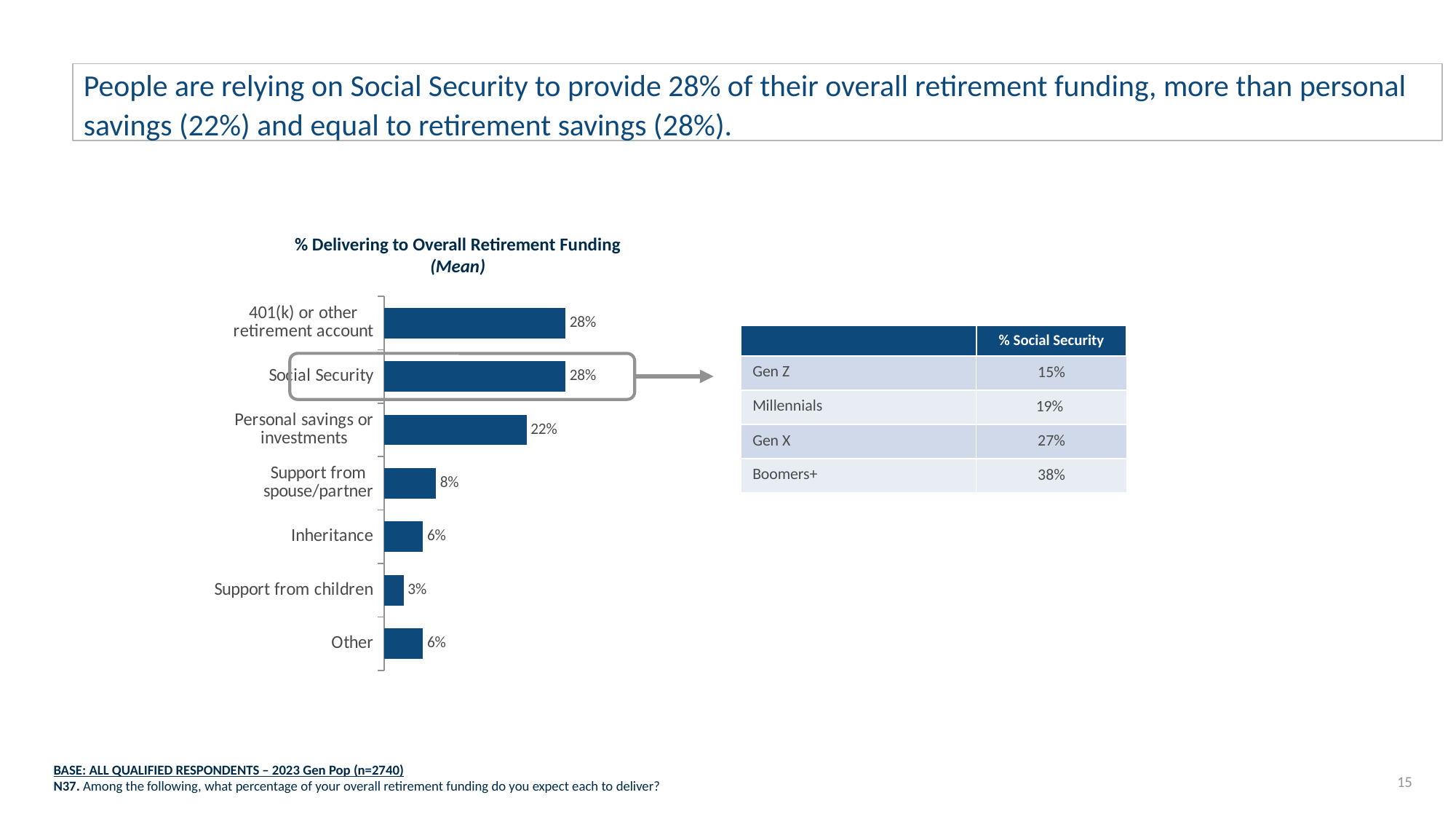
What is the title of the chart? % Delivering to Overall Retirement Funding (Mean) What is the value for Support from spouse/partner? 8% What is the value for Support from children? 3% What is the value for Personal savings or investments? 22% What is the value for Inheritance? 6% Which is larger, the value for Inheritance or the value for Support from children? Inheritance Which category has the lowest value? Support from children How many categories are shown in the bar chart? 7 What kind of chart is shown on the slide? Bar chart What is the difference between the values for Support from spouse/partner and Support from children? 5% Which is larger, the value for Personal savings or investments or the value for Support from spouse/partner? Personal savings or investments What is the difference between the values for Social Security and Personal savings or investments? 6%